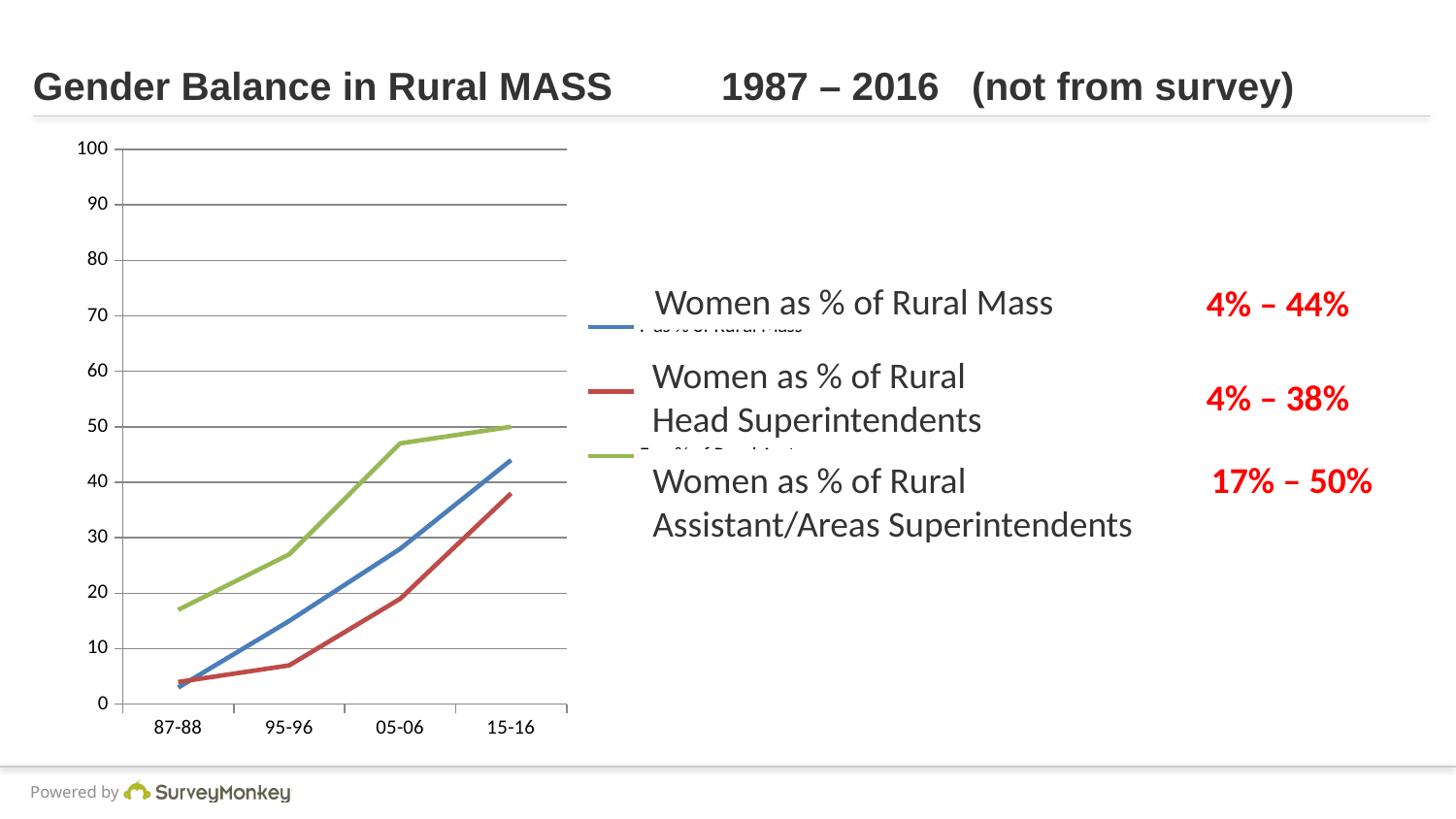
Which series has the highest value at 15-16? Women as % of Rural Assistant/Areas Superintendents How many time points are shown on the x axis? 4 How many series does the chart plot? 3 Do the values for Women as % of Rural Mass rise or fall from 87-88 to 15-16? rise What kind of chart is shown on the slide? line chart At 05-06, which is larger: Women as % of Rural Assistant/Areas Superintendents or Women as % of Rural Head Superintendents? Women as % of Rural Assistant/Areas Superintendents Which colour line represents Women as % of Rural Mass? blue According to the slide, what is the value for Women as % of Rural Assistant/Areas Superintendents at 15-16? 50% According to the slide, what is the value for Women as % of Rural Mass at 15-16? 44% Is the value for Women as % of Rural Head Superintendents at 95-96 greater or less than 10? less Is the value for Women as % of Rural Assistant/Areas Superintendents at 05-06 greater or less than 40? greater Which series has the lowest value at 15-16? Women as % of Rural Head Superintendents